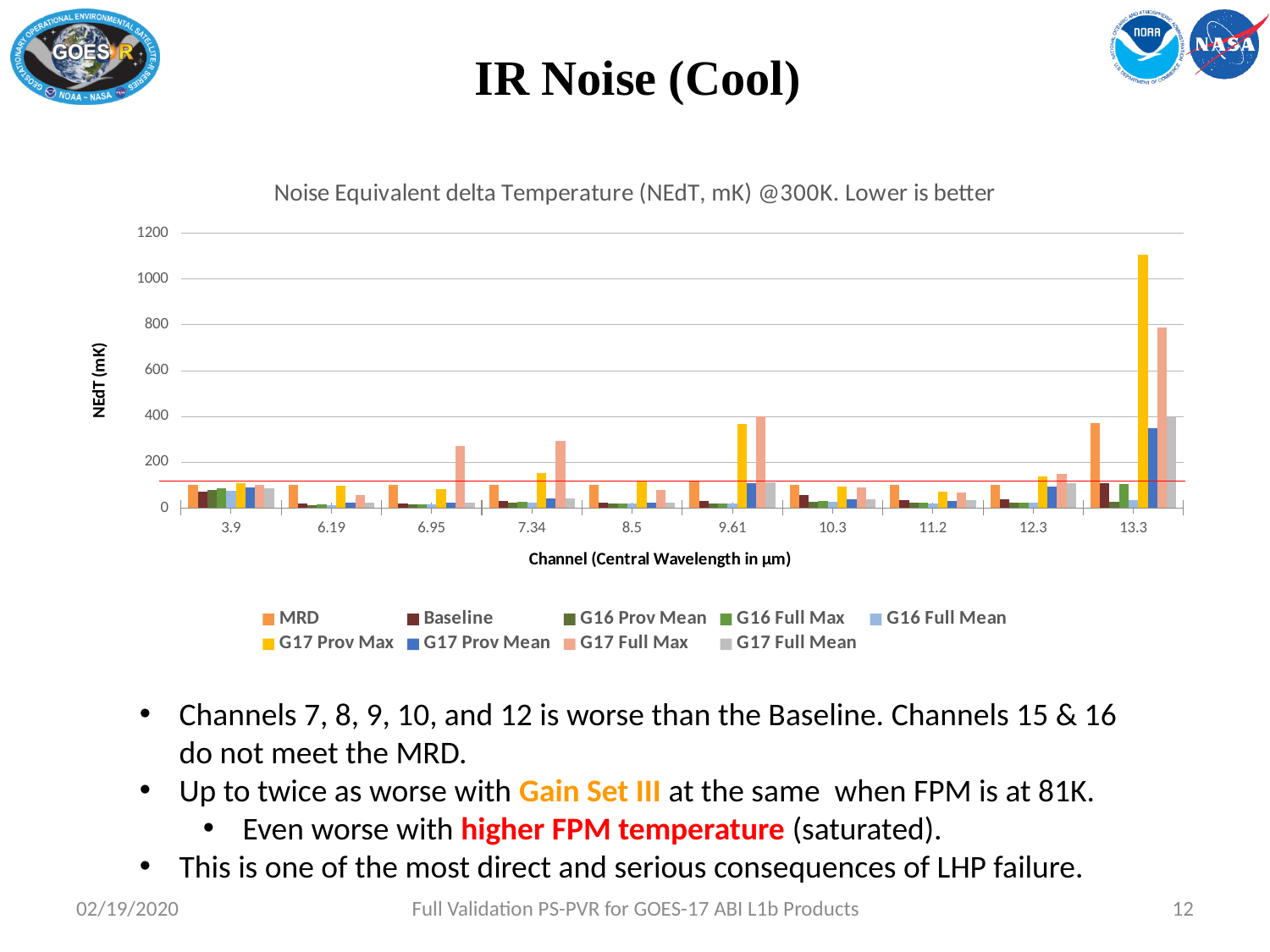
Which channel has the highest G17 Full Max value? 13.3 How many series does the chart's legend list? 9 Is the G17 Prov Max value for channel 9.61 greater or less than 200? greater Which channel has the highest G17 Prov Max value? 13.3 Is the G17 Prov Max value for channel 13.3 greater or less than 1000? greater What is the label of the chart's y axis? NEdT (mK) What is the title of the chart? Noise Equivalent delta Temperature (NEdT, mK) @300K. Lower is better What kind of chart is shown on the slide? Bar chart How many channel categories are shown along the x axis of the chart? 10 Which is larger, the G17 Prov Max value for channel 13.3 or for channel 9.61? 13.3 Is the G17 Full Max value for channel 13.3 greater or less than 600? greater